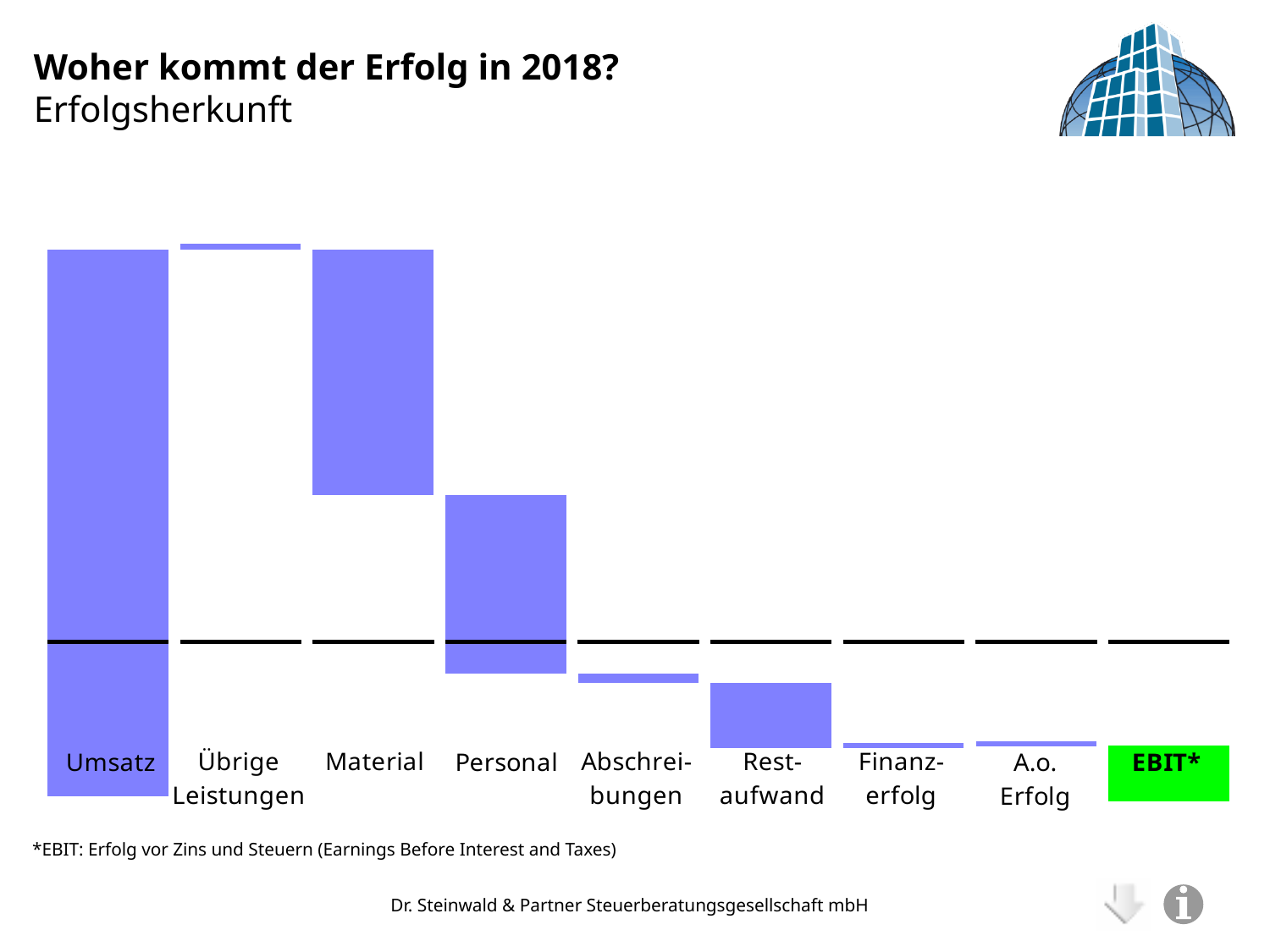
What is the title of the chart slide? Woher kommt der Erfolg in 2018? Which category has the tallest bar in the chart? Umsatz Which bar is taller, Personal or Restaufwand? Personal What colour is the EBIT* bar in the chart? green What is the label of the last category on the x axis? EBIT* What is the label of the first category on the x axis? Umsatz How many categories are shown along the x axis of the chart? 9 Which bar is taller, Umsatz or Material? Umsatz What kind of chart is shown on the slide? bar chart Which bar is taller, Material or Personal? Material